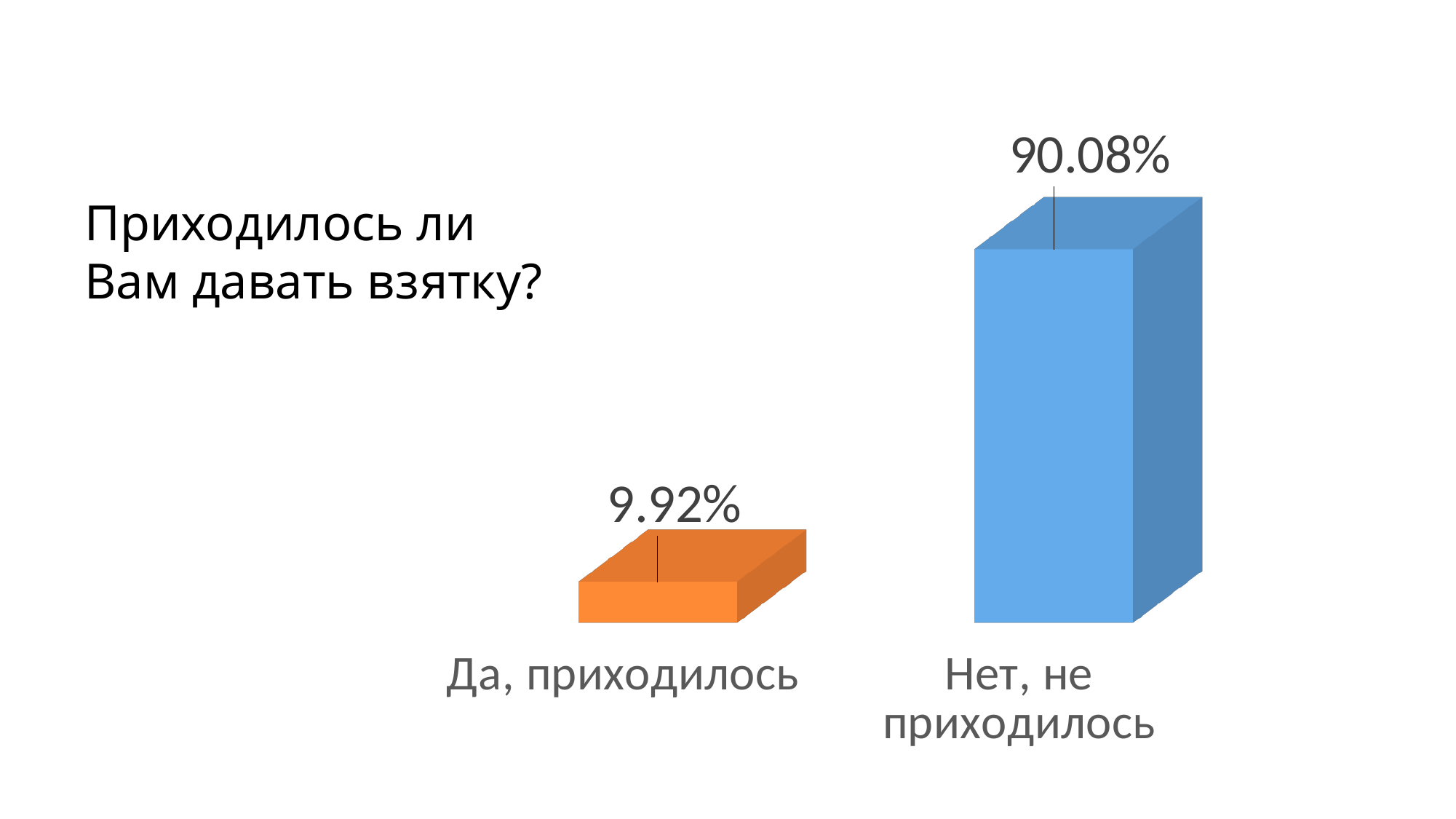
What kind of chart is shown on the slide? bar chart What is the total of the two values shown in the chart? 100% Which category has the lowest value? Да, приходилось What is the difference between the values for "Нет, не приходилось" and "Да, приходилось"? 80.16% How many categories are shown in the chart? 2 What is the value for "Да, приходилось"? 9.92% Which is larger, the value for "Да, приходилось" or the value for "Нет, не приходилось"? Нет, не приходилось What is the value for "Нет, не приходилось"? 90.08% Which category has the highest value? Нет, не приходилось What colour is the bar for "Нет, не приходилось"? blue What question is the chart titled with? Приходилось ли Вам давать взятку?